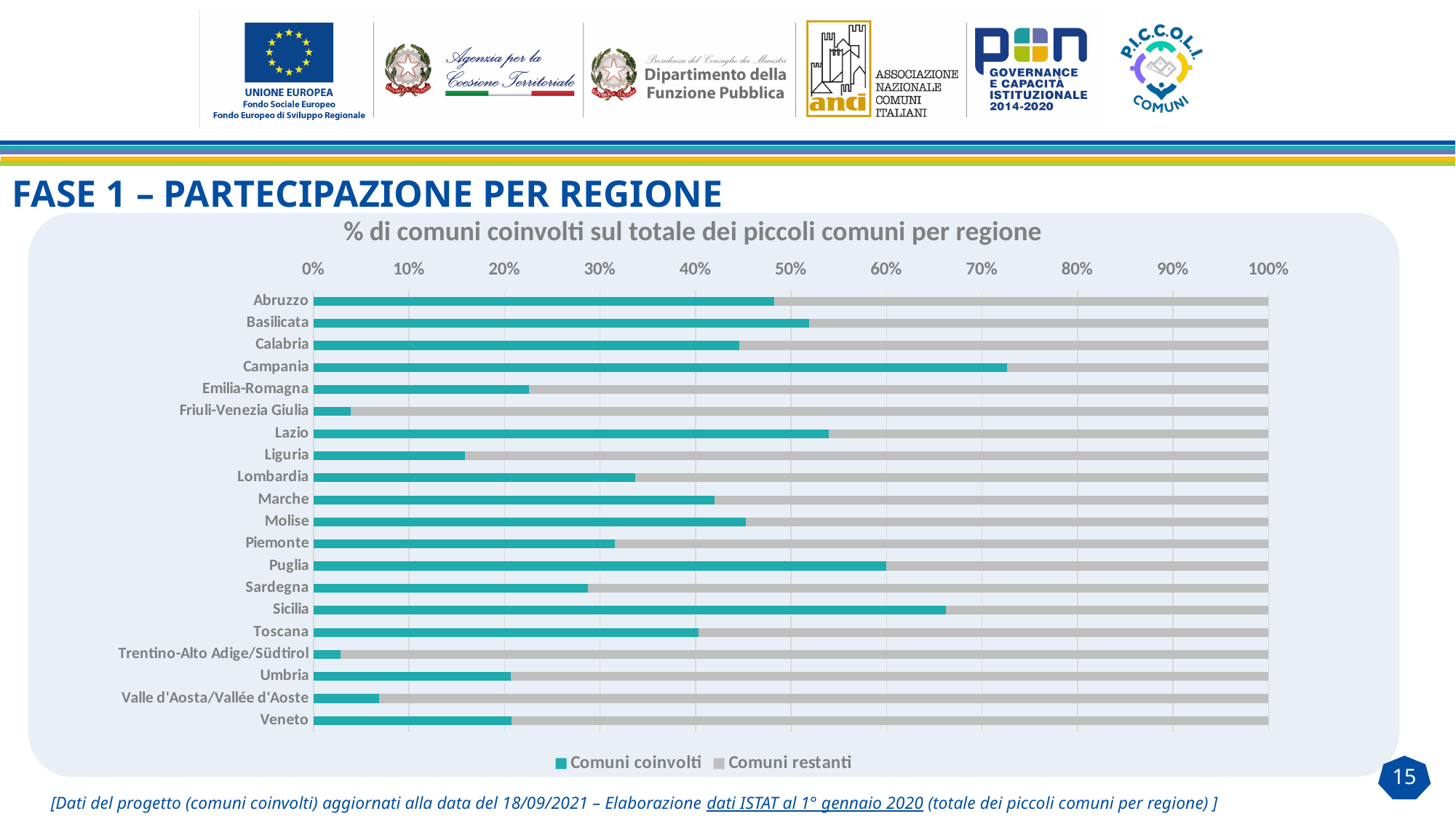
What is the title of the chart? % di comuni coinvolti sul totale dei piccoli comuni per regione Which has a larger share of 'Comuni coinvolti', Puglia or Abruzzo? Puglia Which region has the highest share of 'Comuni coinvolti'? Campania Is the 'Comuni coinvolti' value for Friuli-Venezia Giulia greater or less than 10%? less Which has a larger share of 'Comuni coinvolti', Campania or Sicilia? Campania How many regions are listed on the chart? 20 How many series does the legend list? 2 Is the 'Comuni coinvolti' value for Campania greater or less than 60%? greater Is the 'Comuni coinvolti' value for Puglia greater or less than 50%? greater What kind of chart is shown on the slide? Bar chart